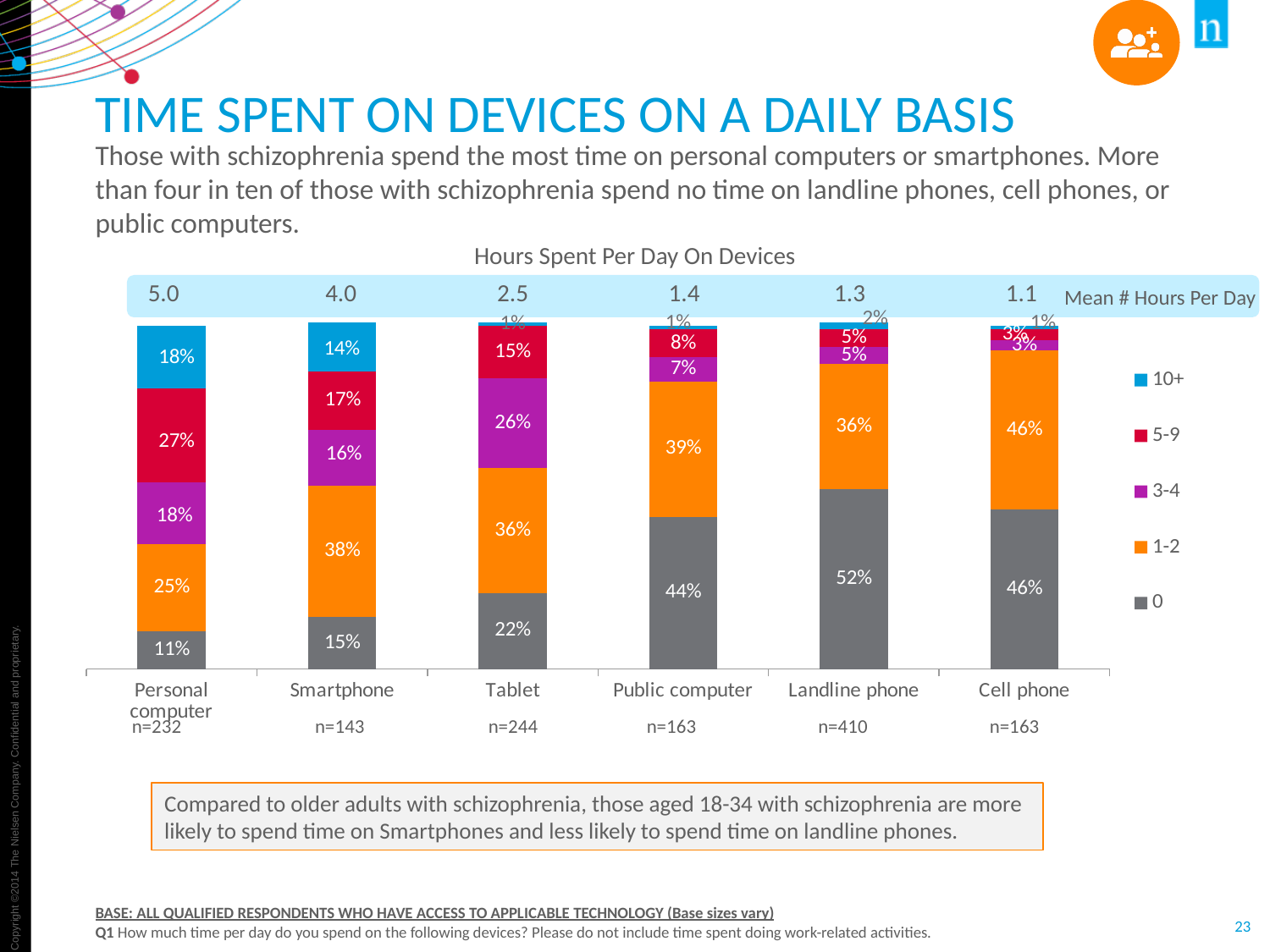
What is the difference between the percentage spending 0 hours on a public computer and the percentage spending 0 hours on a tablet? 22% How many device categories are shown on the x axis of the chart? 6 Which device has the lowest percentage of respondents spending 0 hours per day on it? Personal computer What percentage of respondents spend 1-2 hours per day on a smartphone? 38% How many series does the chart legend list? 5 What is the mean number of hours per day spent on a tablet? 2.5 What percentage of respondents spend 5-9 hours per day on a personal computer? 27% Which device has the highest mean number of hours per day? Personal computer What is the title of the chart? Hours Spent Per Day On Devices What percentage of respondents spend 0 hours per day on a landline phone? 52% What type of chart is shown on the slide? Stacked bar chart Which is larger: the percentage spending 3-4 hours on a tablet or the percentage spending 3-4 hours on a smartphone? Tablet